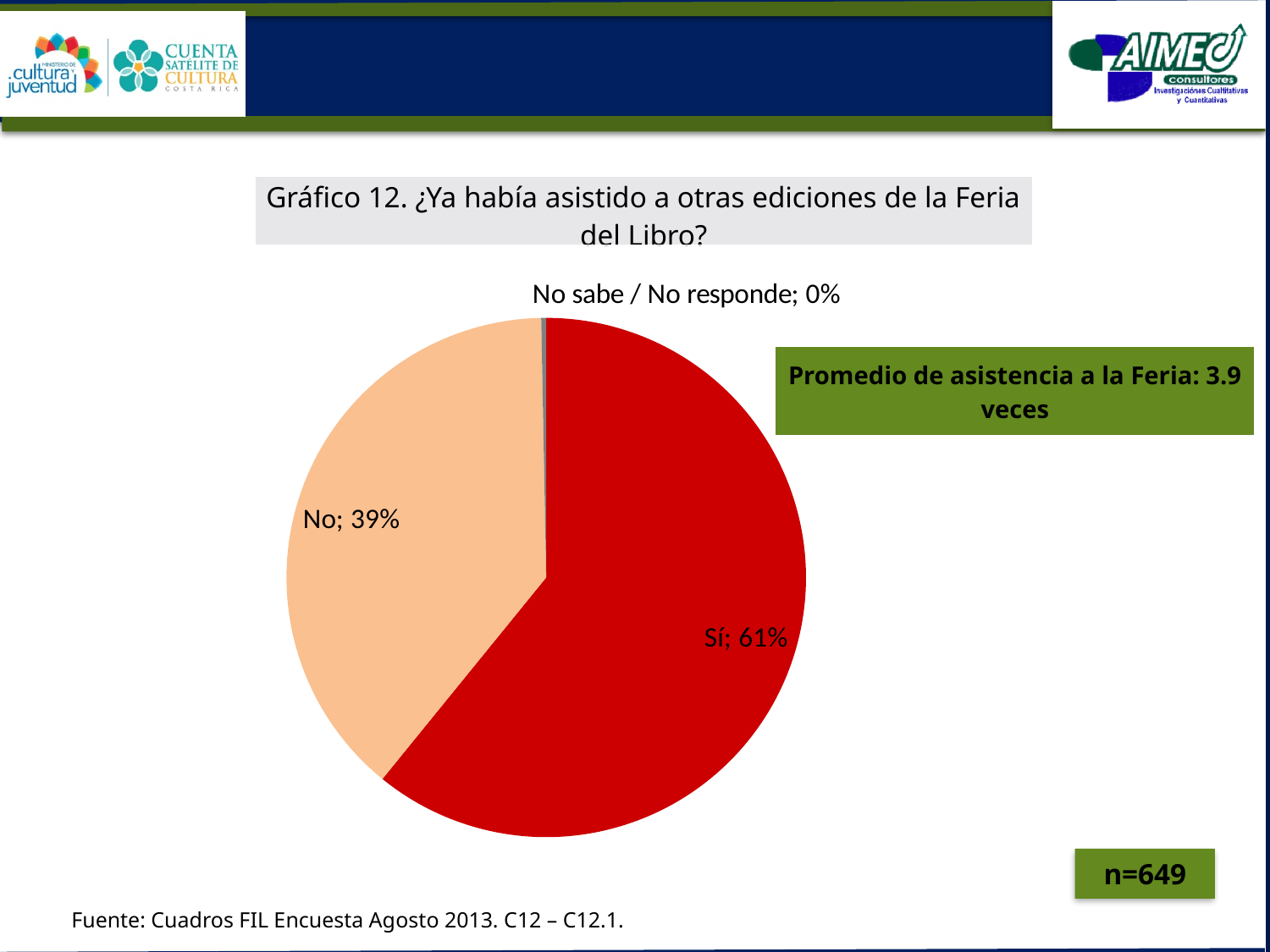
Which category has the largest share of the pie? Sí What kind of chart is shown on the slide? pie chart How many categories are shown in the pie chart? 3 What is the sample size (n) shown on the slide? n=649 What percentage is shown for "No sabe / No responde"? 0% Which category has the smallest share of the pie? No sabe / No responde What percentage of respondents answered "No"? 39% What is the share of the pie for "Sí"? 61% Which is larger, the share for "Sí" or the share for "No"? Sí What is the title of the chart? Gráfico 12. ¿Ya había asistido a otras ediciones de la Feria del Libro? What is the difference in percentage points between "Sí" and "No"? 22 What percentage of respondents answered "Sí"? 61%